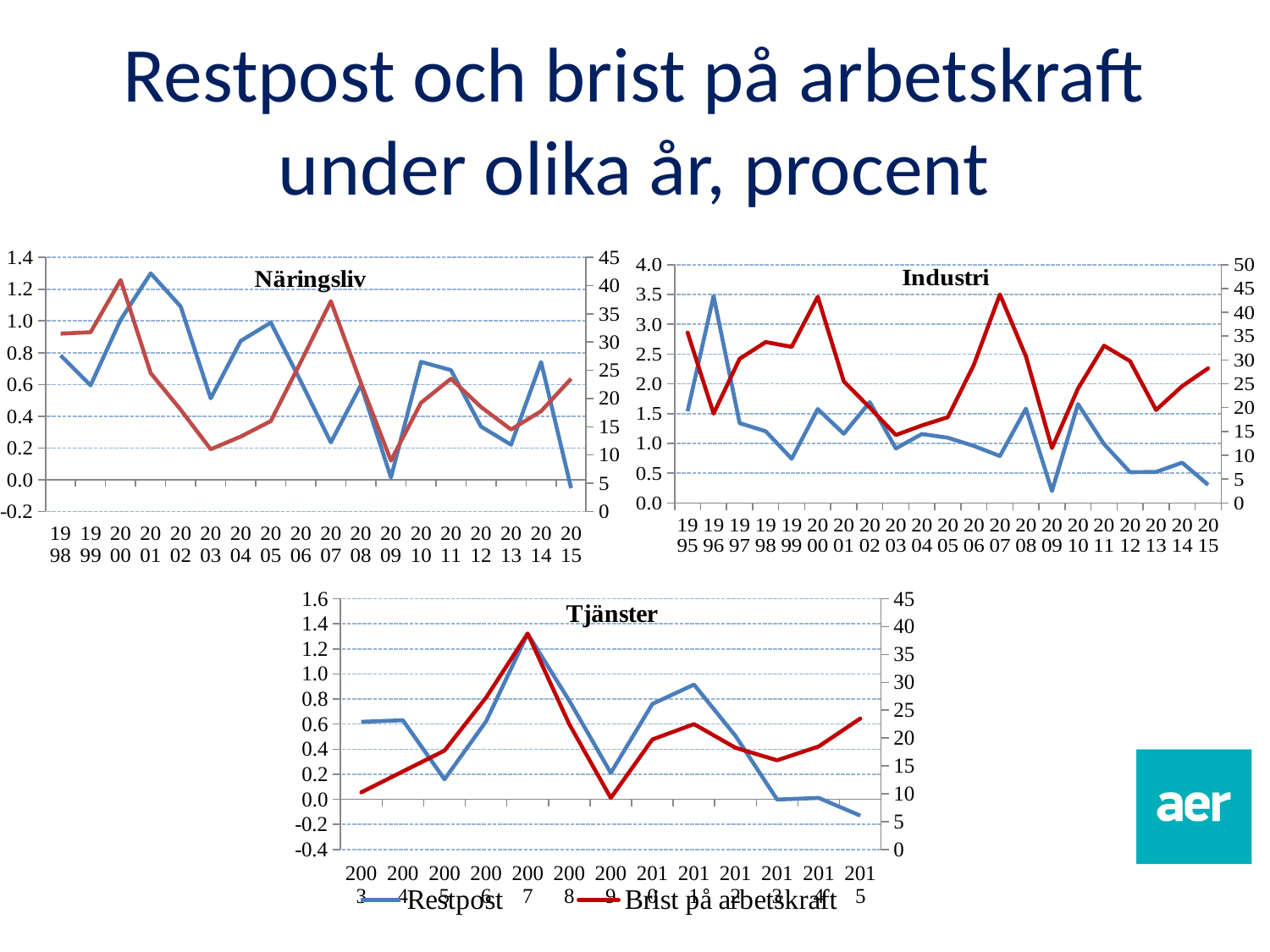
In the Industri chart, is the Restpost value for 1996 greater or less than 3.0? greater What kind of chart is the Näringsliv chart? Line chart How many years are plotted on the x axis of the Tjänster chart? 13 In the Tjänster chart, does Restpost rise or fall from 2011 to 2015? Fall How many series does the legend list? 2 What are the two series named in the legend? Restpost and Brist på arbetskraft How many years are plotted on the x axis of the Industri chart? 21 In the Tjänster chart, is the Brist på arbetskraft value for 2009 greater or less than 15? less In the Industri chart, in which year is Restpost at its lowest? 2009 In the Tjänster chart, in which year does Brist på arbetskraft reach its highest value? 2007 In the Industri chart, in which year does Restpost reach its highest value? 1996 In the Näringsliv chart, in which year does Restpost reach its highest value? 2001